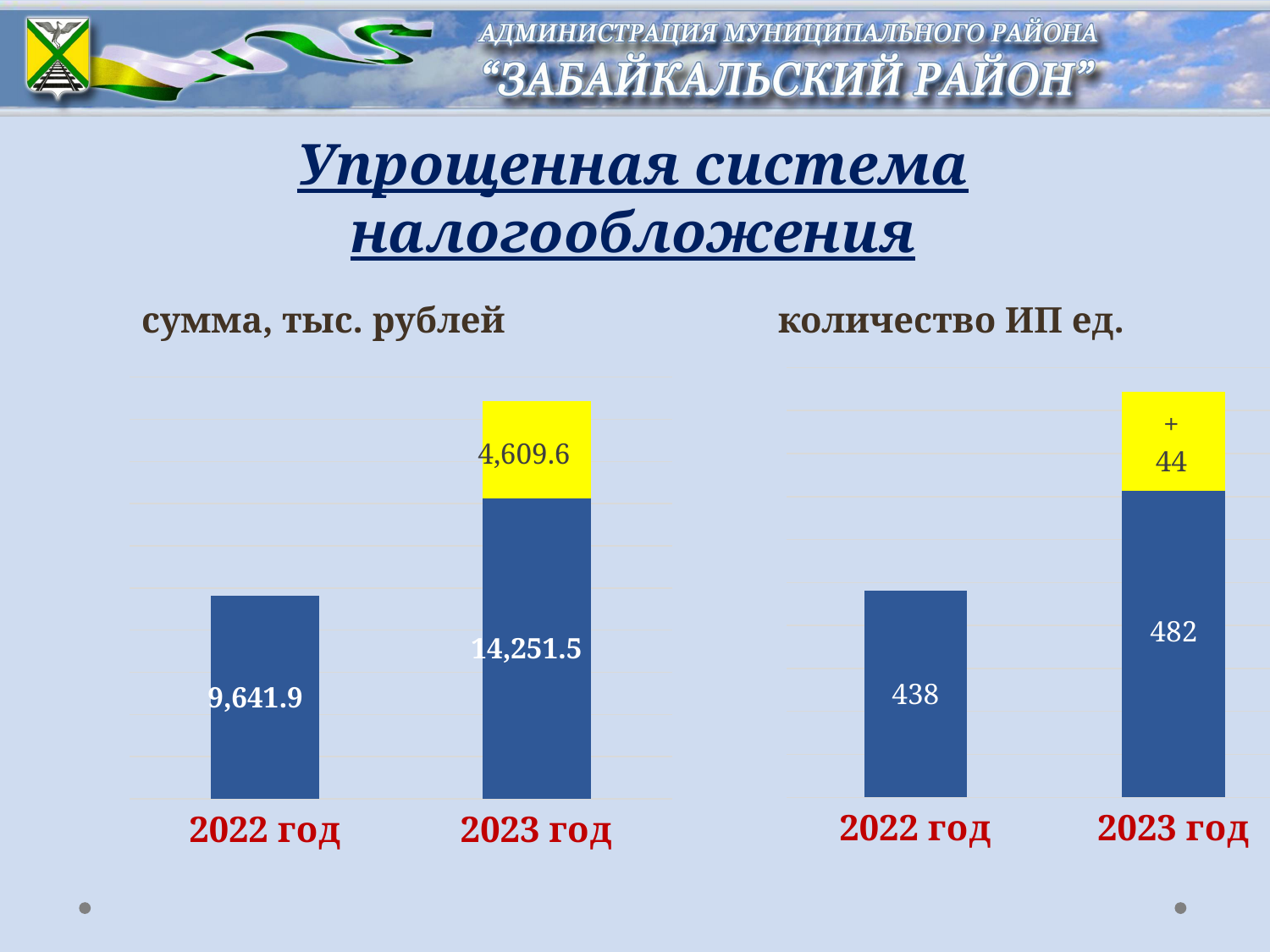
In the chart titled "количество ИП ед.", by how much did the value increase from 2022 год to 2023 год? 44 In the chart titled "сумма, тыс. рублей", what is the difference between the 2023 год and 2022 год values? 4,609.6 In the chart titled "количество ИП ед.", what is the value for 2023 год? 482 In the chart titled "сумма, тыс. рублей", what is the value for 2022 год? 9,641.9 In the chart titled "сумма, тыс. рублей", what is the value for 2023 год? 14,251.5 In the chart titled "количество ИП ед.", which year has the lower value? 2022 год In the chart titled "сумма, тыс. рублей", which year has the higher value? 2023 год In the chart titled "количество ИП ед.", what is printed in the yellow segment above the 2023 год bar? + 44 In the chart titled "количество ИП ед.", what is the value for 2022 год? 438 In the chart titled "сумма, тыс. рублей", what value is printed in the yellow segment above the 2023 год bar? 4,609.6 What type of chart is the one titled "количество ИП ед."? bar chart How many year categories are shown in the chart titled "сумма, тыс. рублей"? 2